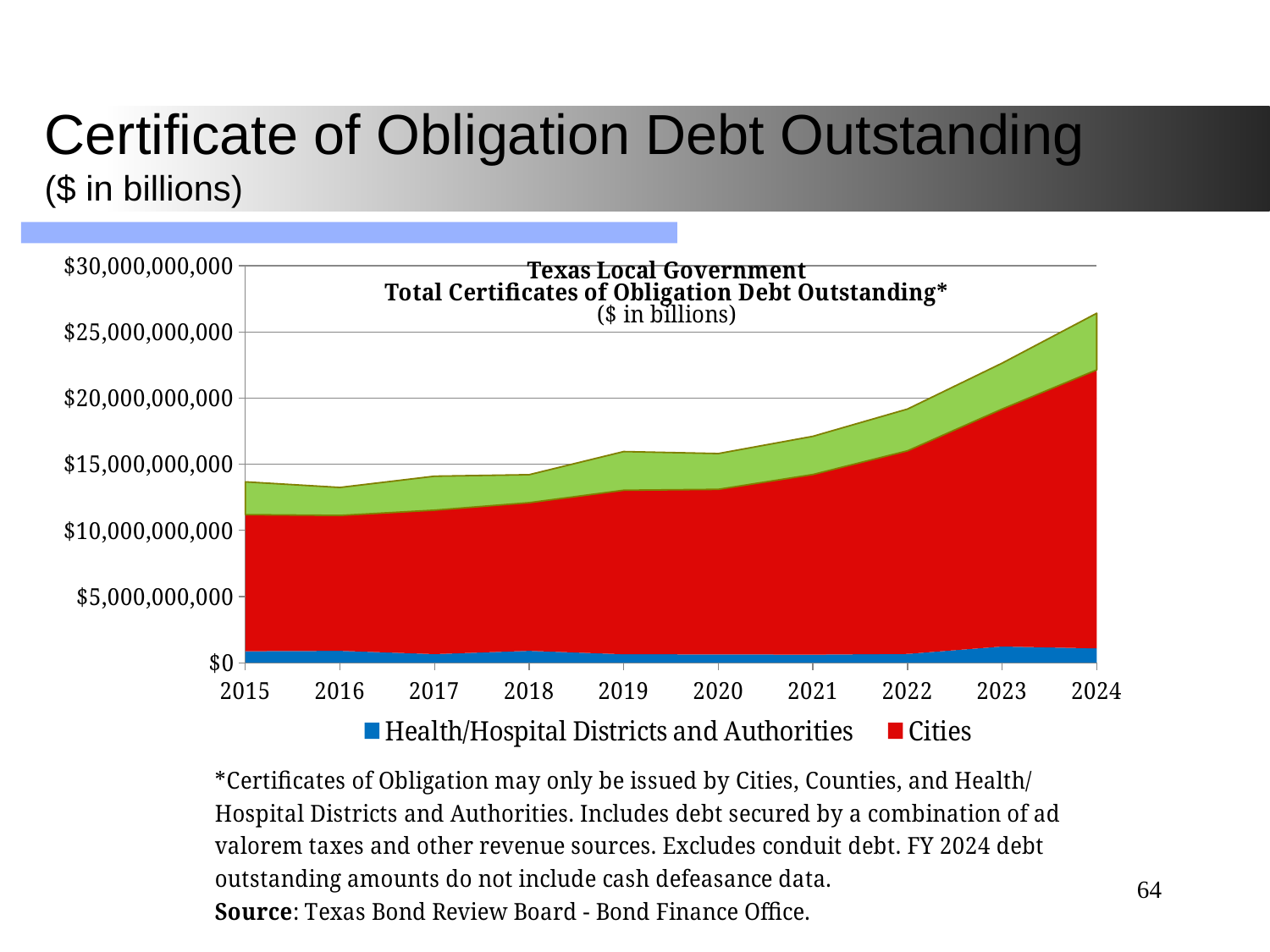
What kind of chart is shown on the slide? Area chart Which is larger, the total debt outstanding in 2024 or in 2015? 2024 Is the value for Cities in 2015 greater or less than $10,000,000,000? greater Is the value for Health/Hospital Districts and Authorities in 2020 greater or less than $5,000,000,000? less How many years are shown along the x axis of the chart? 10 What colour represents Cities in the chart? Red How many series does the chart's legend list? 2 Is the total debt outstanding in 2024 greater or less than $25,000,000,000? greater Does the total debt outstanding generally rise or fall from 2015 to 2024? Rise Which year has the highest total certificates of obligation debt outstanding? 2024